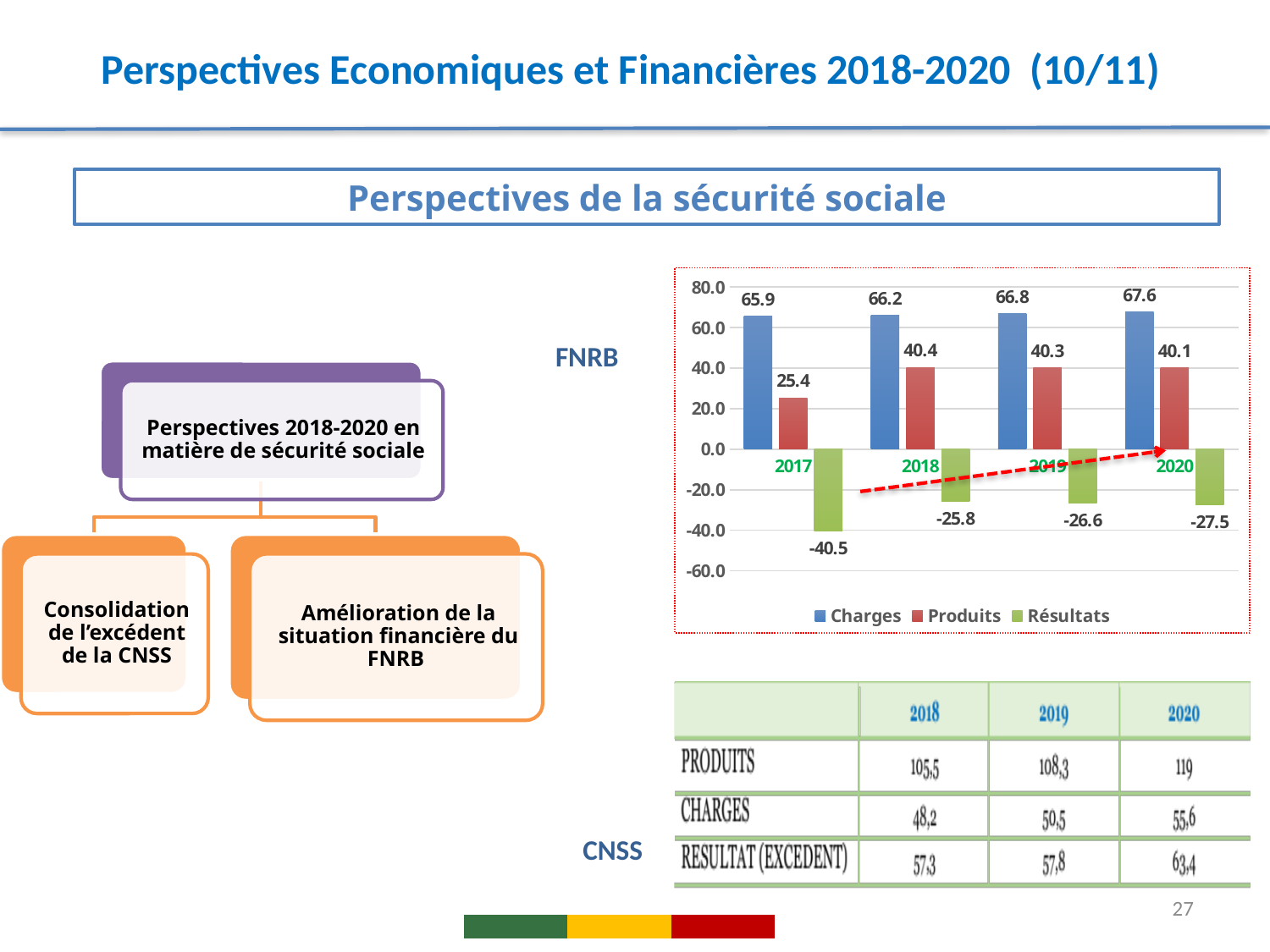
In the FNRB chart, what is the value of Résultats for 2018? -25.8 In the FNRB chart, which is larger: Produits in 2018 or Produits in 2017? Produits in 2018 In the FNRB chart, what is the value of Charges for 2020? 67.6 In the FNRB chart, what is the value of Produits for 2017? 25.4 In the FNRB chart, do the Charges values rise or fall from 2017 to 2020? rise What kind of chart is the FNRB chart? bar chart In the FNRB chart, is the Charges value for 2019 greater or less than 60.0? greater In the FNRB chart, which year has the lowest Produits value? 2017 How many series does the legend of the FNRB chart list? 3 In the FNRB chart, which year has the highest Charges value? 2020 How many years are shown on the x axis of the FNRB chart? 4 In the FNRB chart, what is the difference between Charges and Produits in 2018? 25.8